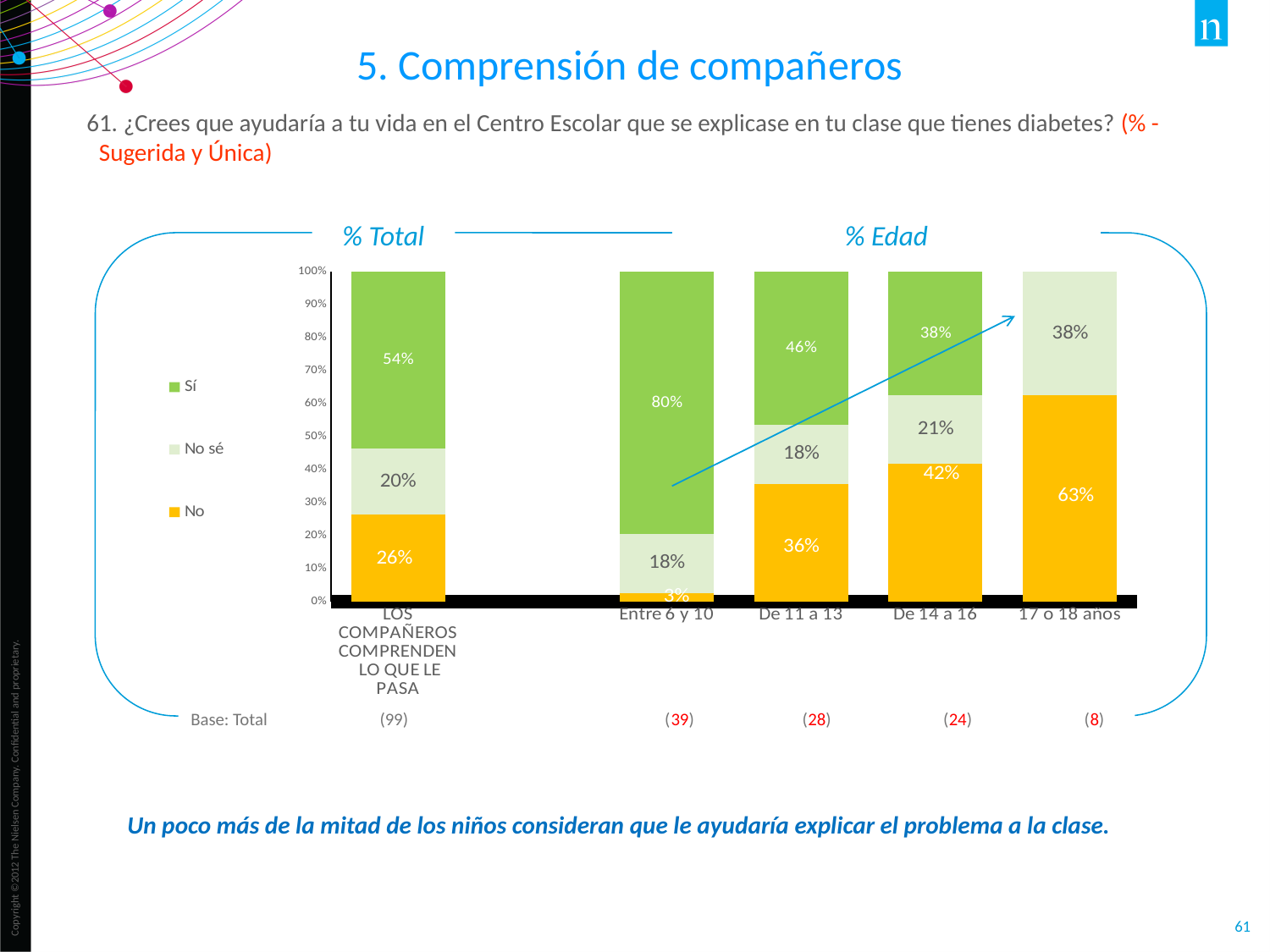
What kind of chart is shown on the slide? stacked bar chart What is the 'No' value for the total bar ('LOS COMPAÑEROS COMPRENDEN LO QUE LE PASA')? 26% How many series does the legend list? 3 What is the 'No sé' value for the 'De 14 a 16' age group? 21% What is the 'Sí' value for the 'Entre 6 y 10' age group? 80% What is the 'No' value for the '17 o 18 años' age group? 63% What is the difference between the 'Sí' values for 'Entre 6 y 10' and 'De 11 a 13'? 34 percentage points Does the 'No' value rise or fall across the age groups from 'Entre 6 y 10' to '17 o 18 años'? rise Which age group has the lowest 'No' value? Entre 6 y 10 Which age group has the highest 'Sí' value? Entre 6 y 10 What is the base (number of respondents) shown for the 'De 11 a 13' age group? 28 Which is larger for the 'De 14 a 16' group: the 'Sí' value or the 'No' value? No